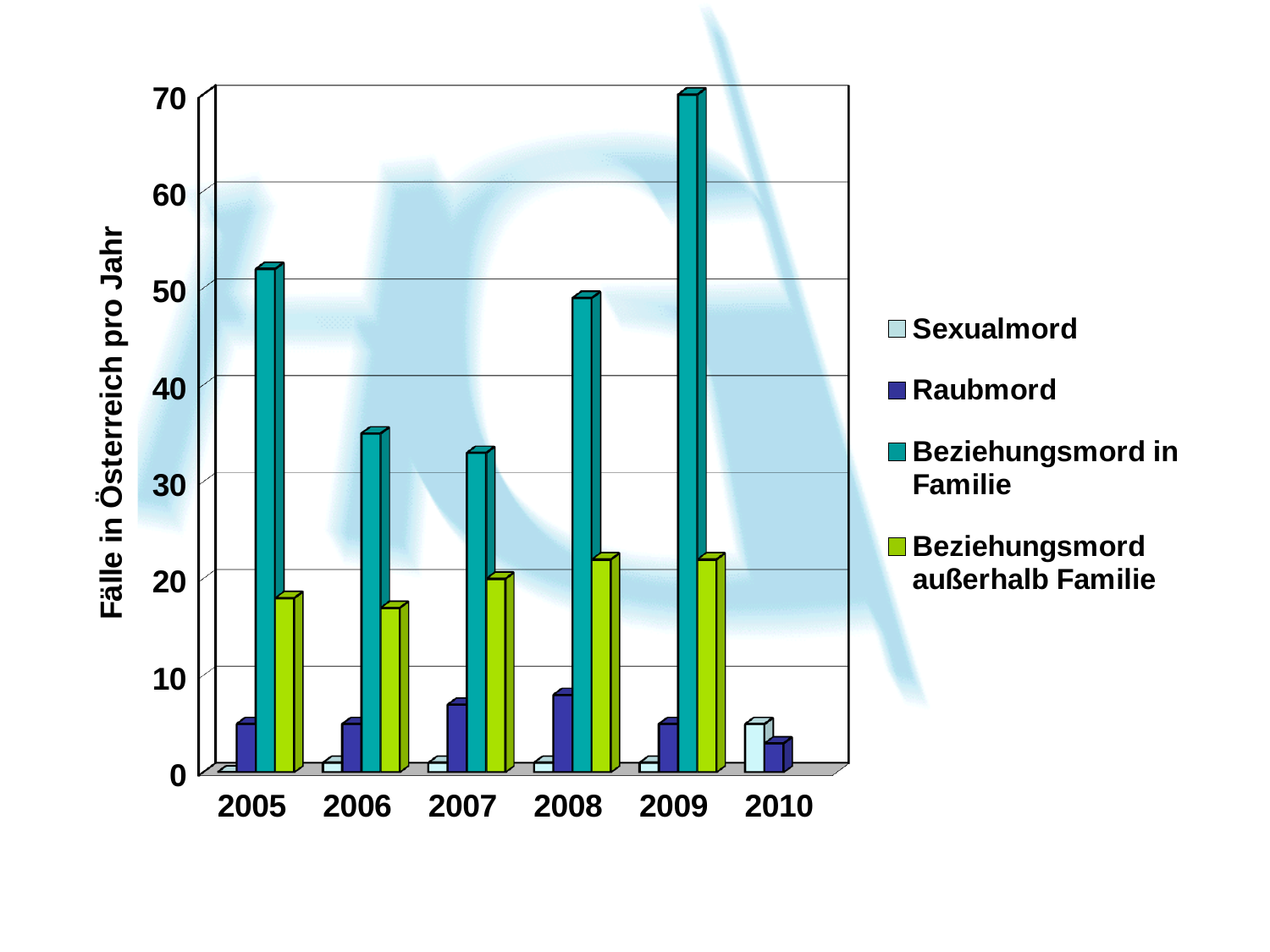
Is the value for Beziehungsmord in Familie in 2006 greater or less than 40? less Is the value for Beziehungsmord in Familie in 2008 greater or less than 40? greater How many years are shown on the x axis? 6 Is the value for Raubmord in 2008 greater or less than 10? less Which is larger, the value for Beziehungsmord in Familie in 2005 or in 2006? 2005 Which series has the highest value in 2010? Sexualmord What is the label on the vertical axis? Fälle in Österreich pro Jahr What kind of chart is shown on the slide? bar chart How many series does the legend list? 4 In which year is the value for Beziehungsmord in Familie highest? 2009